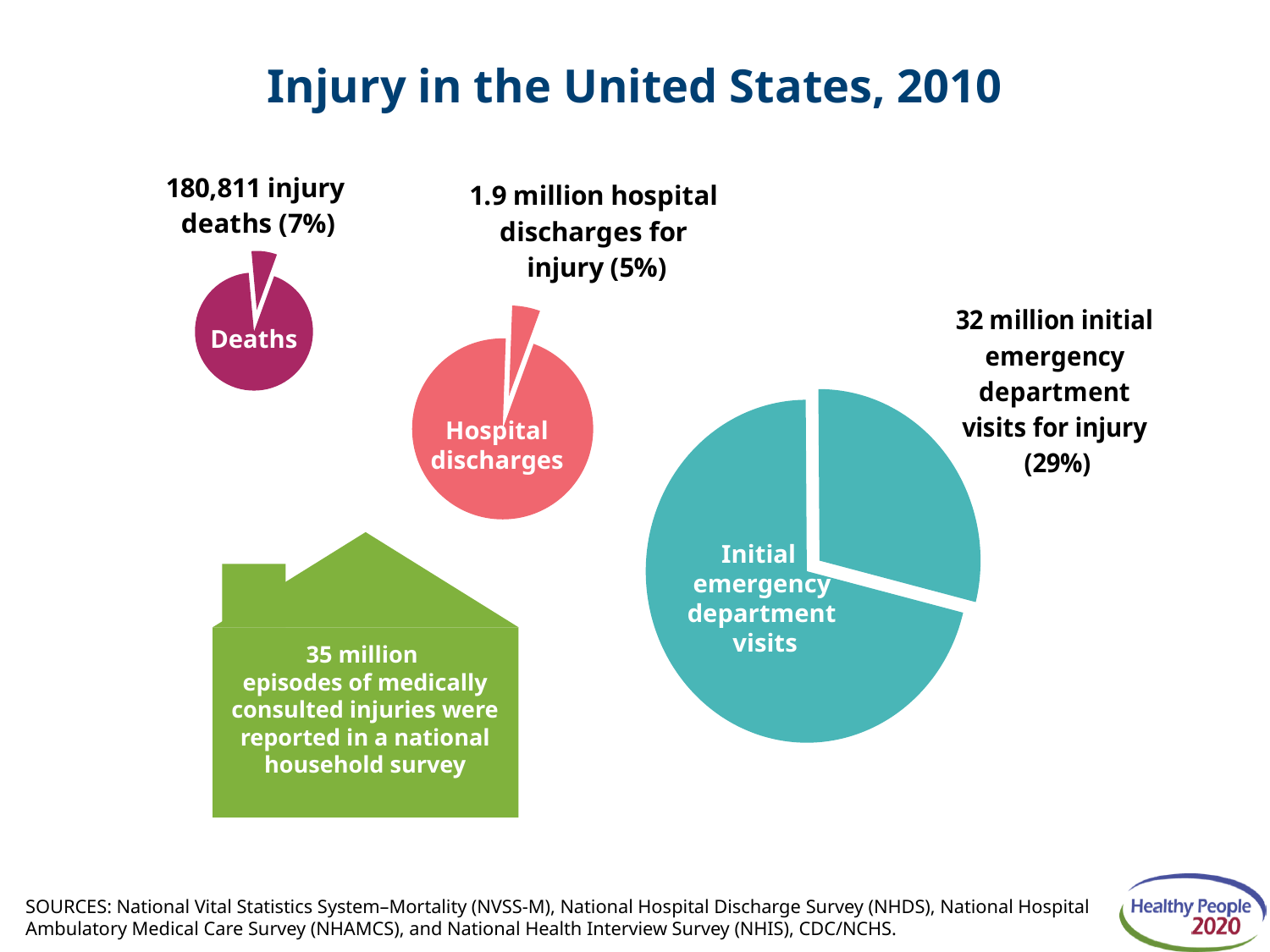
Across the three pie charts, which category has the smallest injury share? Hospital discharges In the Initial emergency department visits pie chart, what percentage of visits is for injury? 29% What kind of charts are shown on the slide? Pie charts In the Deaths pie chart, how many injury deaths are reported? 180,811 In the Hospital discharges pie chart, how many hospital discharges for injury are reported? 1.9 million In the Deaths pie chart, what percentage of deaths is attributed to injury? 7% Which is larger: the injury share in the Deaths pie chart or in the Hospital discharges pie chart? Deaths In the Hospital discharges pie chart, what percentage of hospital discharges is for injury? 5% Across the three pie charts, which category has the largest injury share? Initial emergency department visits In the Initial emergency department visits pie chart, how many initial emergency department visits for injury are reported? 32 million What is the difference between the injury share in the Initial emergency department visits pie chart and the injury share in the Deaths pie chart? 22 percentage points How many pie charts are on the slide? 3